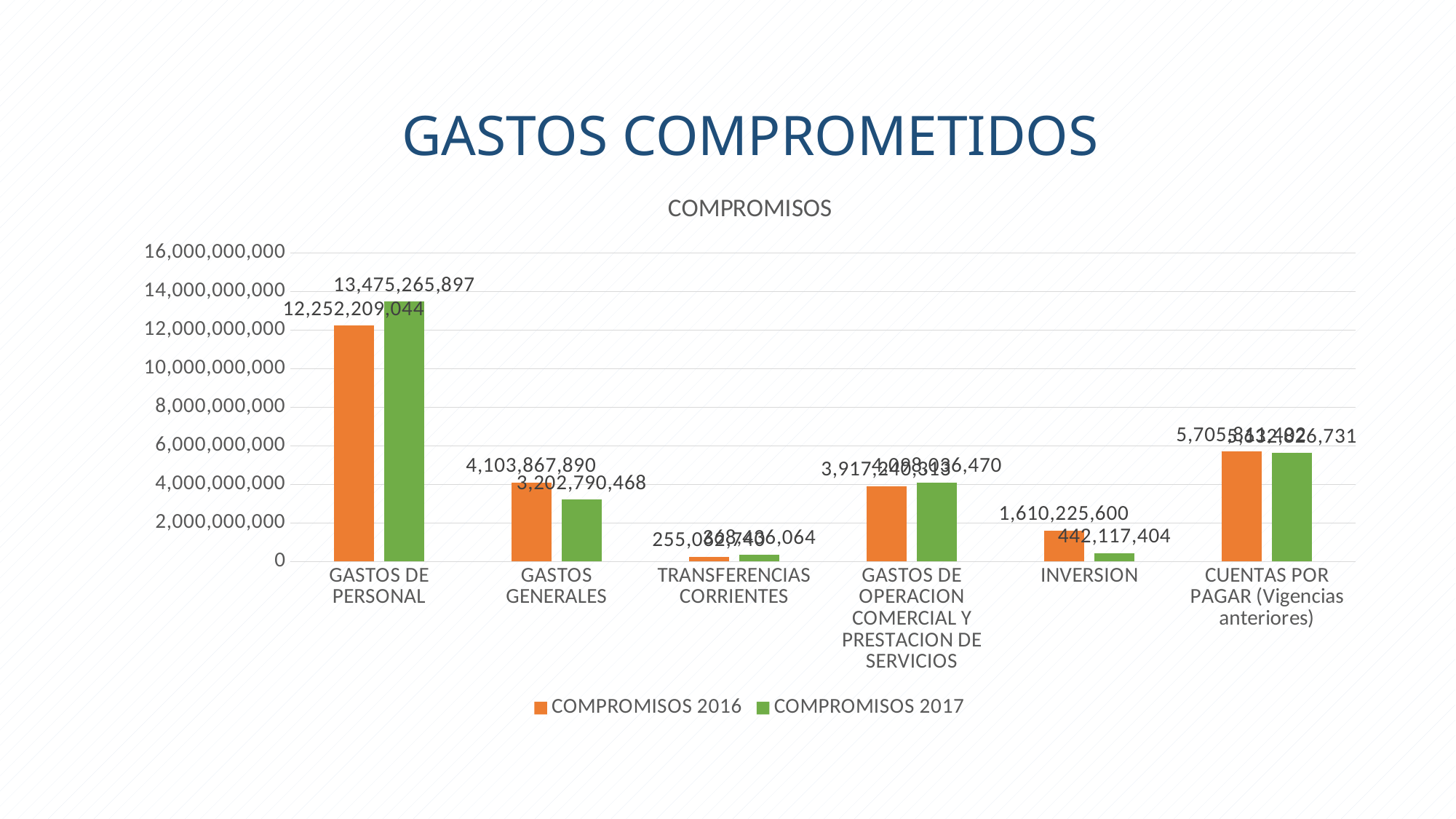
How many categories are shown on the x axis of the chart? 6 For INVERSION, which is larger: COMPROMISOS 2016 or COMPROMISOS 2017? COMPROMISOS 2016 What is the value of COMPROMISOS 2017 for INVERSION? 442,117,404 Which category has the highest COMPROMISOS 2017 value? GASTOS DE PERSONAL What is the value of COMPROMISOS 2016 for GASTOS GENERALES? 4,103,867,890 What is the value of COMPROMISOS 2017 for GASTOS DE PERSONAL? 13,475,265,897 Is the COMPROMISOS 2016 value for CUENTAS POR PAGAR (Vigencias anteriores) greater or less than 4,000,000,000? greater How many series does the legend list? 2 What is the difference between COMPROMISOS 2017 and COMPROMISOS 2016 for GASTOS DE PERSONAL? 1,223,056,853 Which category has the lowest COMPROMISOS 2016 value? TRANSFERENCIAS CORRIENTES What is the value of COMPROMISOS 2016 for GASTOS DE PERSONAL? 12,252,209,044 What is the difference between COMPROMISOS 2016 and COMPROMISOS 2017 for GASTOS GENERALES? 901,077,422